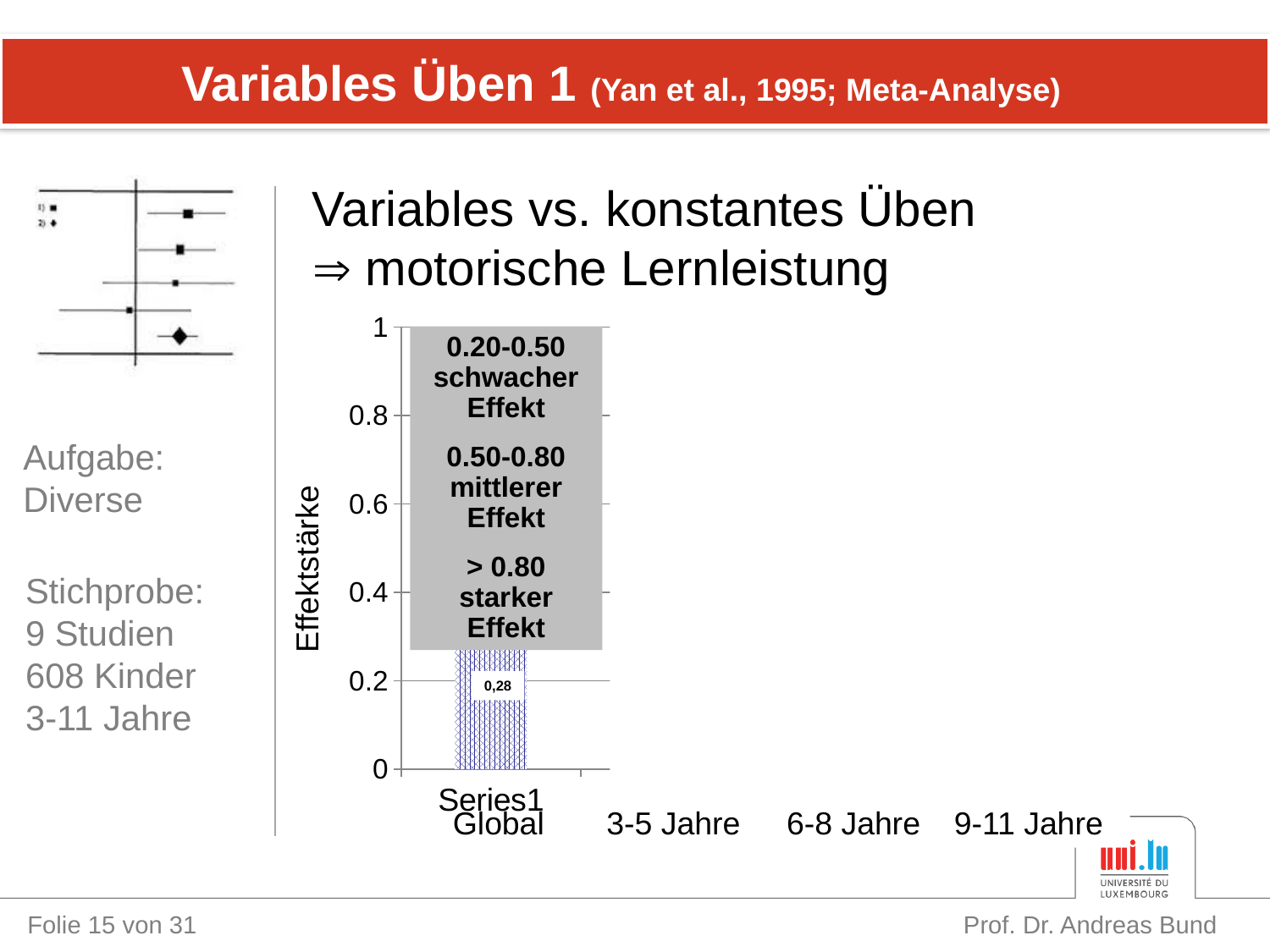
What is the effect size (Effektstärke) shown for the Global bar? 0,28 According to the grey box in the chart, which range of effect sizes is labelled 'mittlerer Effekt'? 0.50-0.80 What is the label of the vertical axis of the chart? Effektstärke What kind of chart is shown on the slide? bar chart Is the value for the Global bar greater or less than 0.2? greater Is the value for the Global bar greater or less than 0.4? less How many bars are plotted in the chart? 1